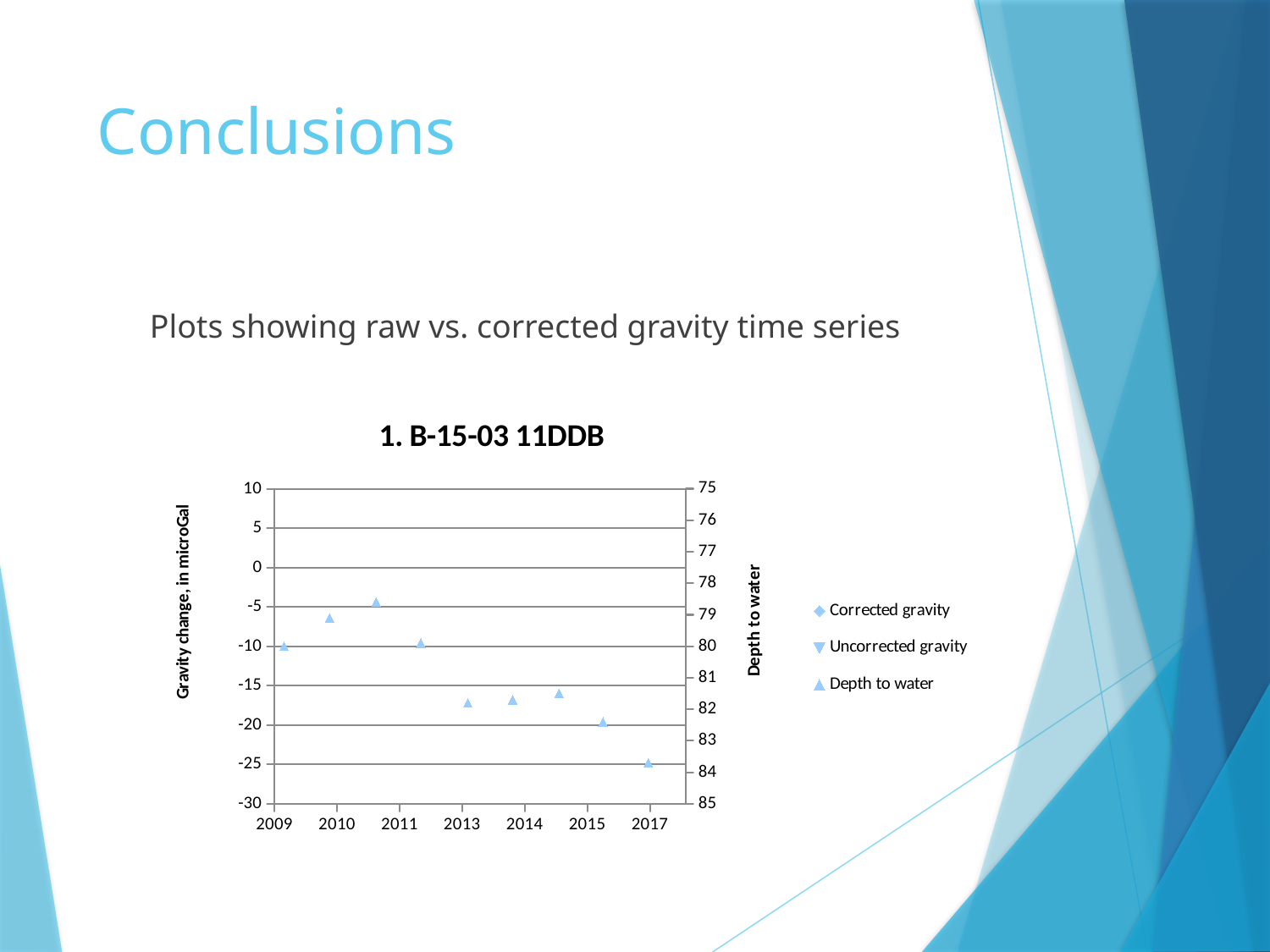
What kind of chart is shown on the slide? scatter chart Is the depth to water value for the point at 2013 greater or less than 80 on the right axis? greater At which year label is the plotted point lowest on the chart? 2017 How many series does the chart legend list? 3 Do the plotted points generally move up or down on the chart from 2009 to 2017? down How many data points are plotted on the chart? 9 Is the depth to water value for the 2017 point greater or less than 80 on the right axis? greater Which plotted point sits higher on the chart, the one at 2009 or the one at 2017? 2009 Which series is the only one with points visibly plotted on the chart? Depth to water What is the label of the left vertical axis? Gravity change, in microGal What is the title of the chart? 1. B-15-03 11DDB Is the depth to water value for the point at 2010 greater or less than 80 on the right axis? less